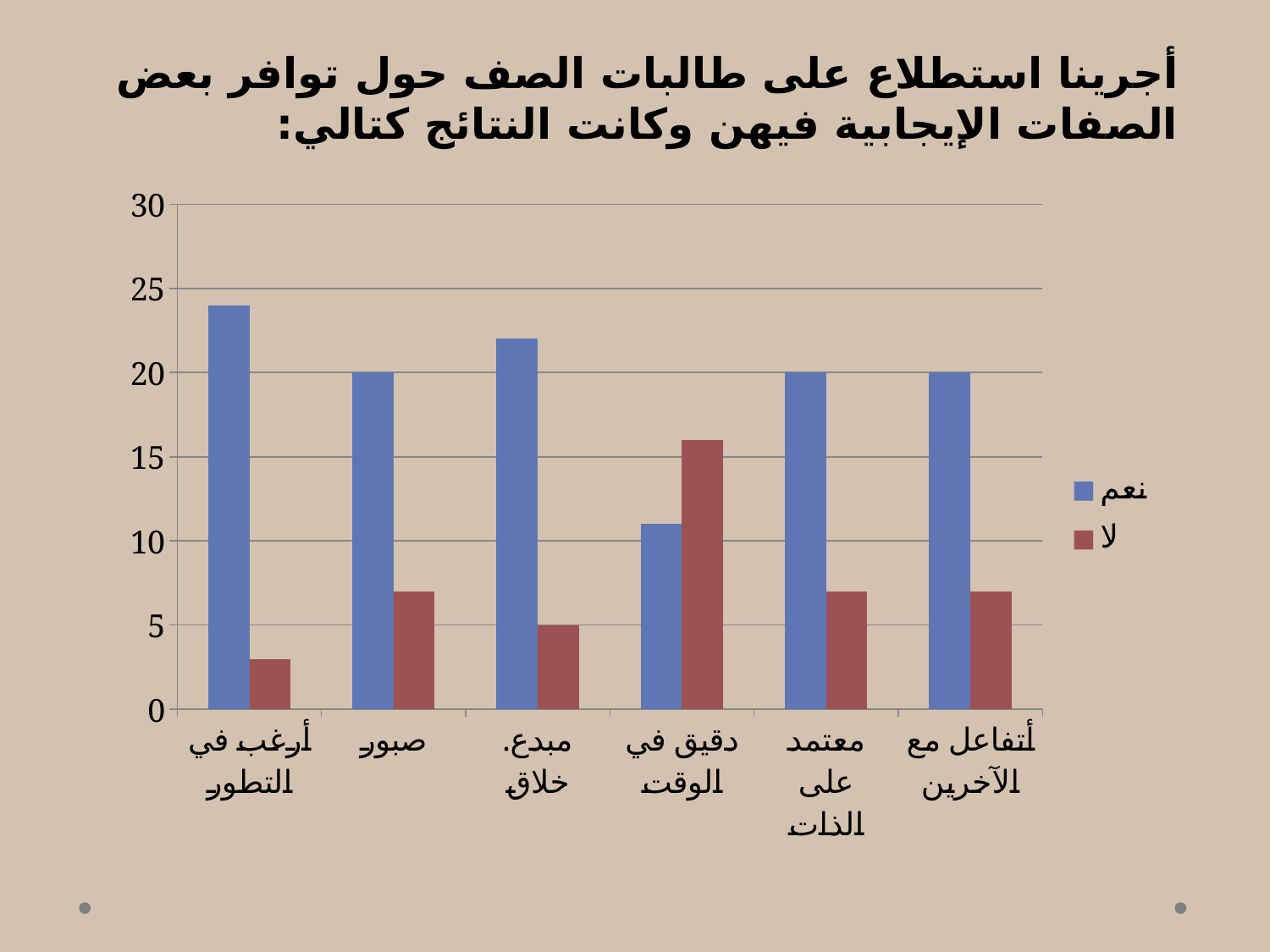
How many series does the legend list? 2 How many categories are shown on the x axis? 6 What is the value of نعم for صبور? 20 Which category has the highest value for نعم? أرغب في التطور Which category has the lowest value for لا? أرغب في التطور Which category has the highest value for لا? دقيق في الوقت What is the value of لا for مبدع. خلاق? 5 Which category has the lowest value for نعم? دقيق في الوقت What kind of chart is shown on the slide? bar chart Is the value of نعم for أرغب في التطور greater or less than 20? greater Is the value of لا for دقيق في الوقت greater or less than 15? greater For دقيق في الوقت, which is larger: نعم or لا? لا